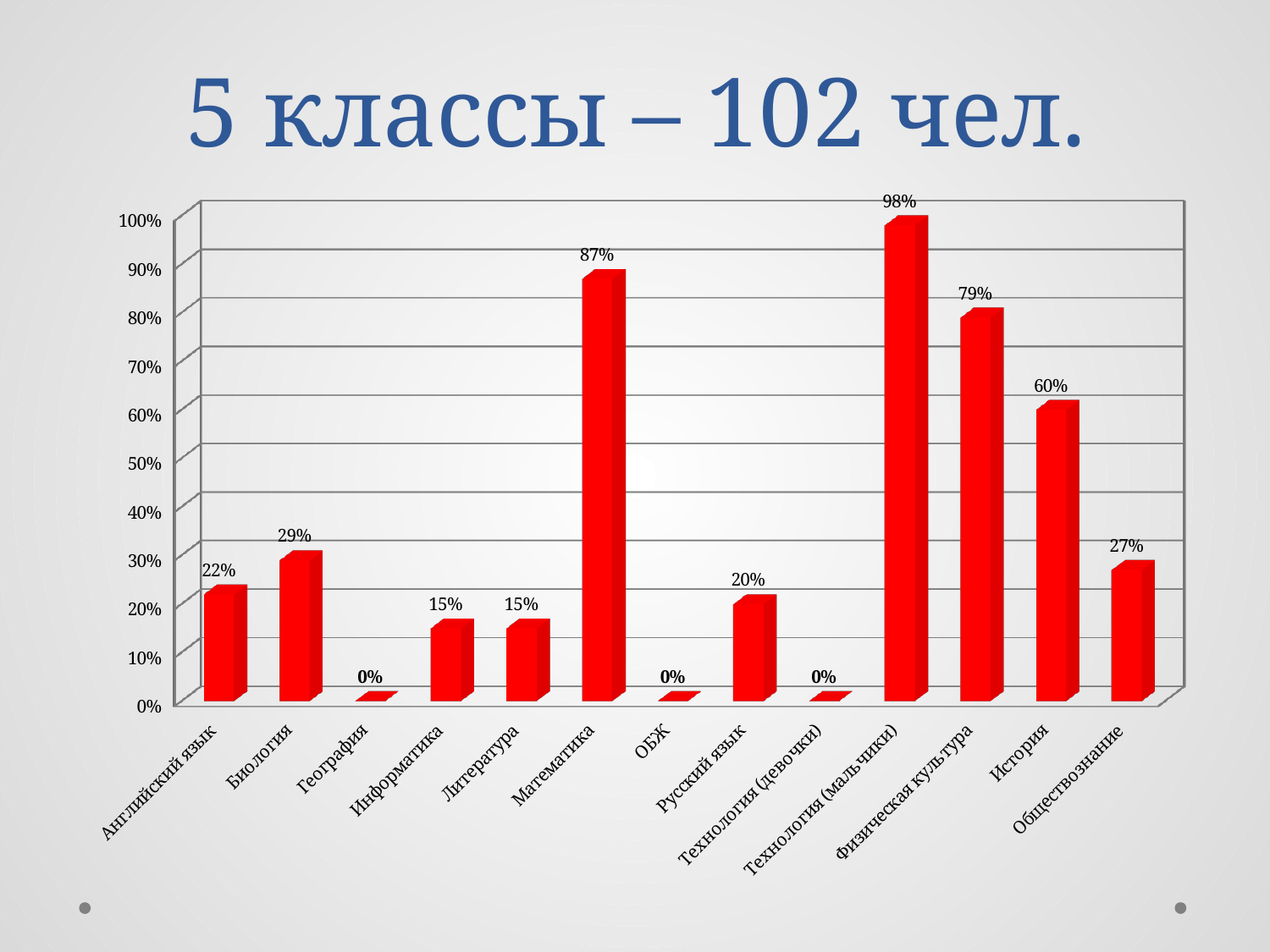
Which is larger, the value for Биология or the value for Обществознание? Биология What is the value for Математика? 87% What is the value for Английский язык? 22% What colour are the bars in the chart? red How many categories have a value of 0%? 3 Which category has the highest value? Технология (мальчики) What is the title of the slide? 5 классы – 102 чел. What kind of chart is shown on the slide? bar chart Is the value for История greater or less than 50%? greater What is the difference between the values for Технология (мальчики) and История? 38% What is the value for Физическая культура? 79% How many categories are shown on the x axis? 13